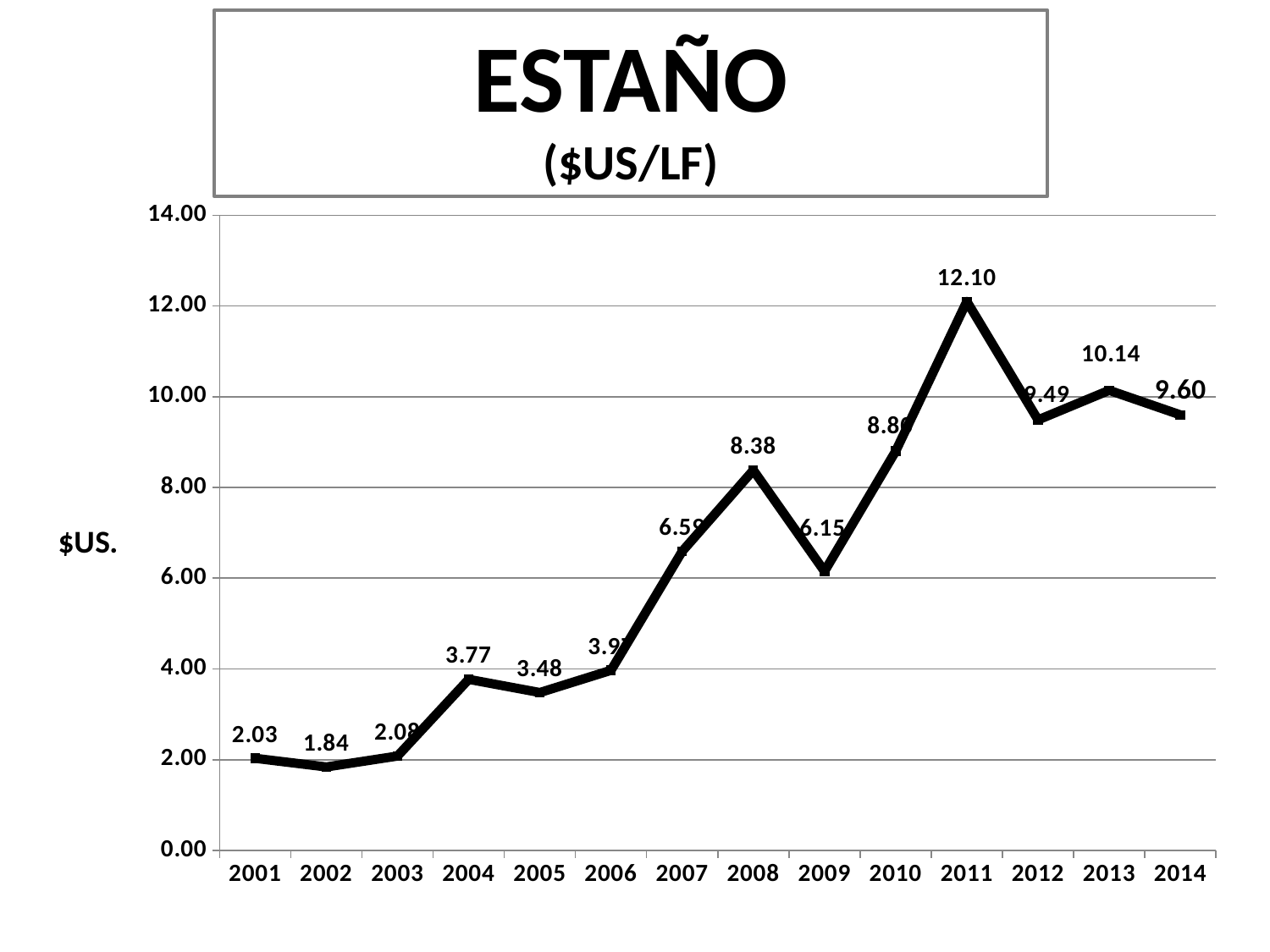
What is the value for 2013? 10.14 How many years are plotted on the x axis? 14 Which year has the lowest value? 2002 What kind of chart is shown? line chart Which year has the larger value, 2008 or 2009? 2008 Which year has the highest value? 2011 What is the title of the chart? ESTAÑO ($US/LF) What is the value for 2001? 2.03 What is the difference between the values for 2011 and 2012? 2.61 What is the value for 2011? 12.10 Is the value for 2010 greater or less than 8.00? greater Is the value for 2006 greater or less than 6.00? less